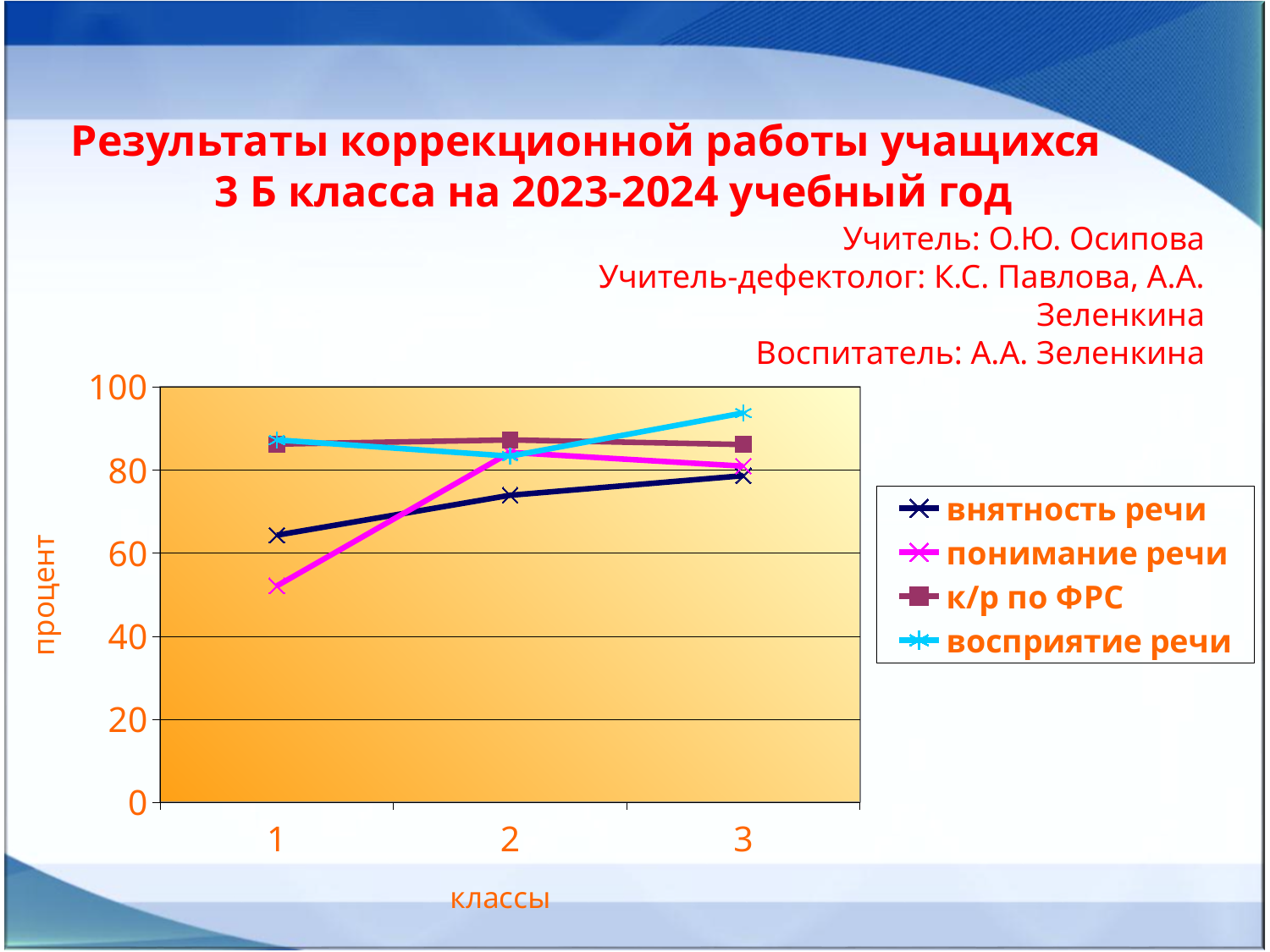
At класс 1, which is larger: к/р по ФРС or понимание речи? к/р по ФРС What is the title of the vertical axis? процент Is the value for внятность речи at класс 1 greater or less than 60? greater Which series has the highest value at класс 3? восприятие речи How many series does the legend list? 4 How many categories (классы) are plotted along the x axis? 3 Is the value for восприятие речи at класс 3 greater or less than 80? greater What kind of chart is shown on the slide? line chart Is the value for понимание речи at класс 1 greater or less than 60? less Which series has the lowest value at класс 1? понимание речи Does the value for внятность речи rise or fall from класс 1 to класс 3? rise